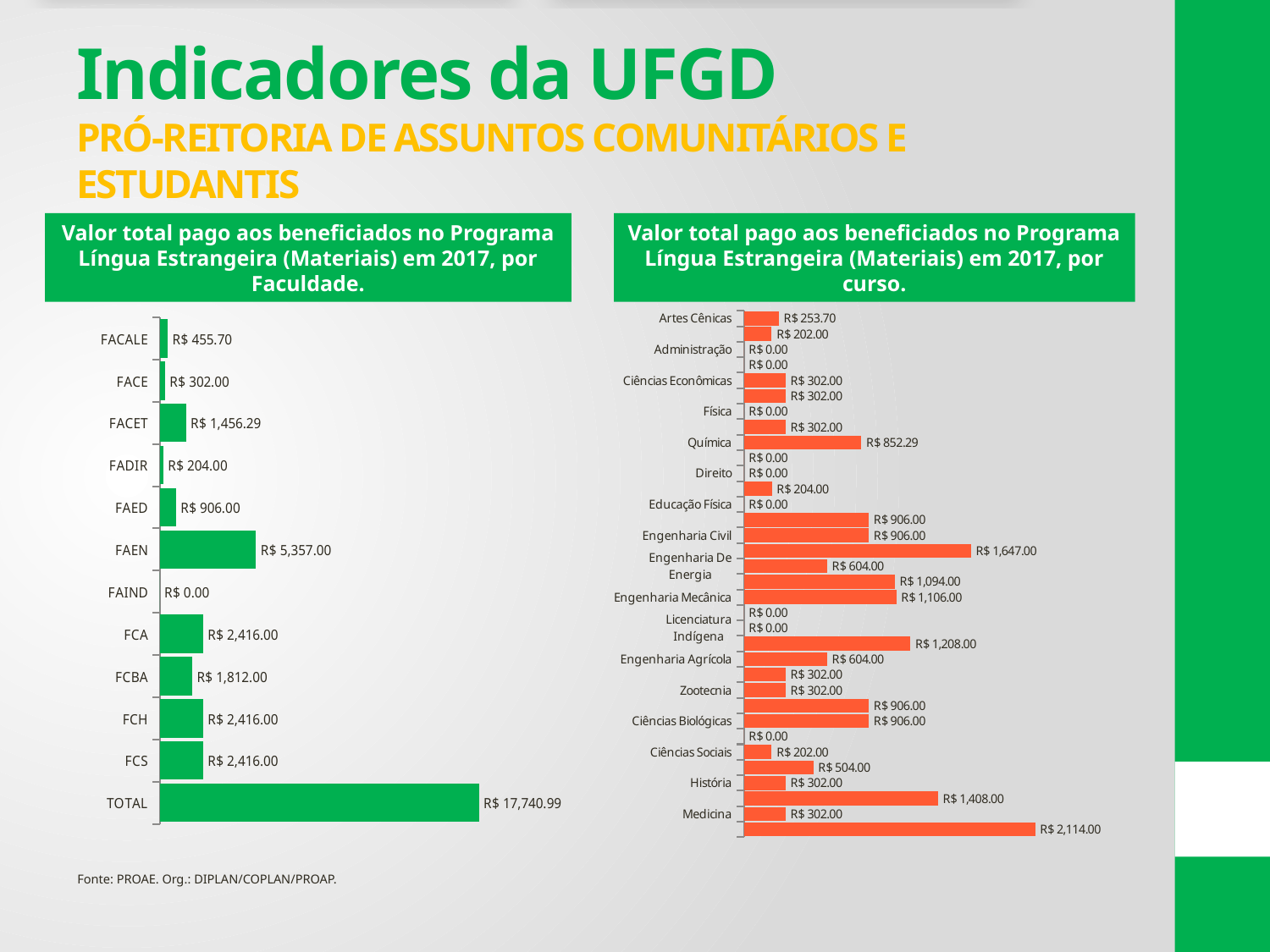
In the chart 'por Faculdade' on the left, what is the value shown for TOTAL? R$ 17,740.99 In the chart 'por Faculdade' on the left, excluding the TOTAL bar, which faculdade has the highest value? FAEN In the chart 'por Faculdade' on the left, which is larger, the value for FCBA or the value for FAED? FCBA In the chart 'por Faculdade' on the left, what is the difference between the values for FAEN and FCA? R$ 2,941.00 In the chart 'por Faculdade' on the left, what is the value for FACET? R$ 1,456.29 What colour are the bars in the chart 'por Faculdade' on the left? Green In the chart 'por Faculdade' on the left, what is the value for FADIR? R$ 204.00 How many bars (categories) are shown in the chart 'por Faculdade' on the left? 12 What kind of chart is the chart 'por curso' on the right? Bar chart In the chart 'por Faculdade' on the left, what is the value for FAEN? R$ 5,357.00 In the chart 'por Faculdade' on the left, which faculdade has the lowest value? FAIND What kind of chart is the chart 'por Faculdade' on the left? Bar chart